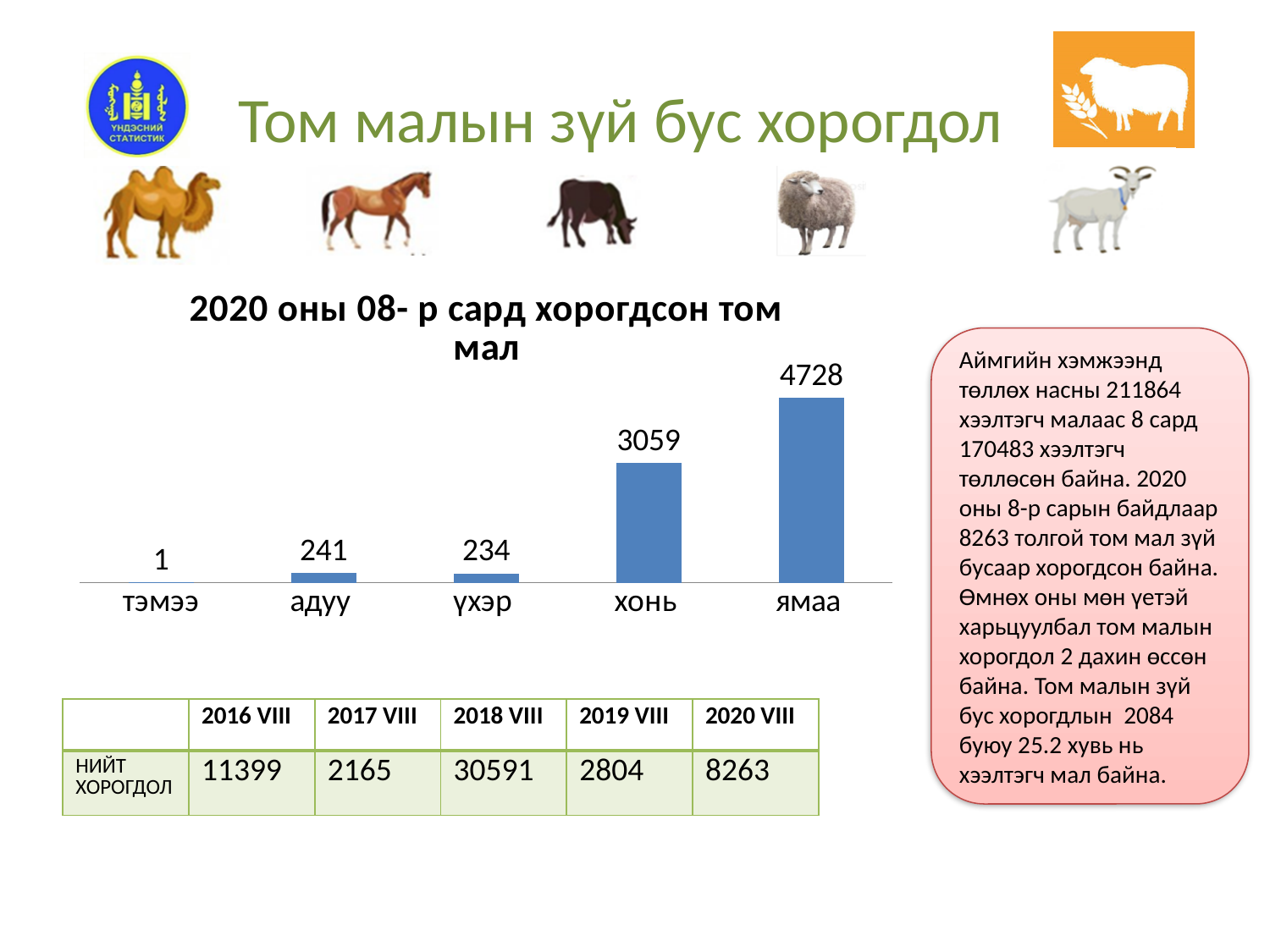
Which category has the highest value in the chart? ямаа What is the value for хонь in the chart? 3059 Which category has the lowest value in the chart? тэмээ What is the difference between the values for ямаа and хонь? 1669 What is the difference between the values for адуу and үхэр? 7 What is the title of the chart? 2020 оны 08- р сард хорогдсон том мал What kind of chart is shown on the slide? bar chart What is the value for ямаа in the chart? 4728 What is the value for тэмээ in the chart? 1 Which is larger, the value for хонь or the value for үхэр? хонь How many categories are shown in the chart? 5 What is the value for адуу in the chart? 241